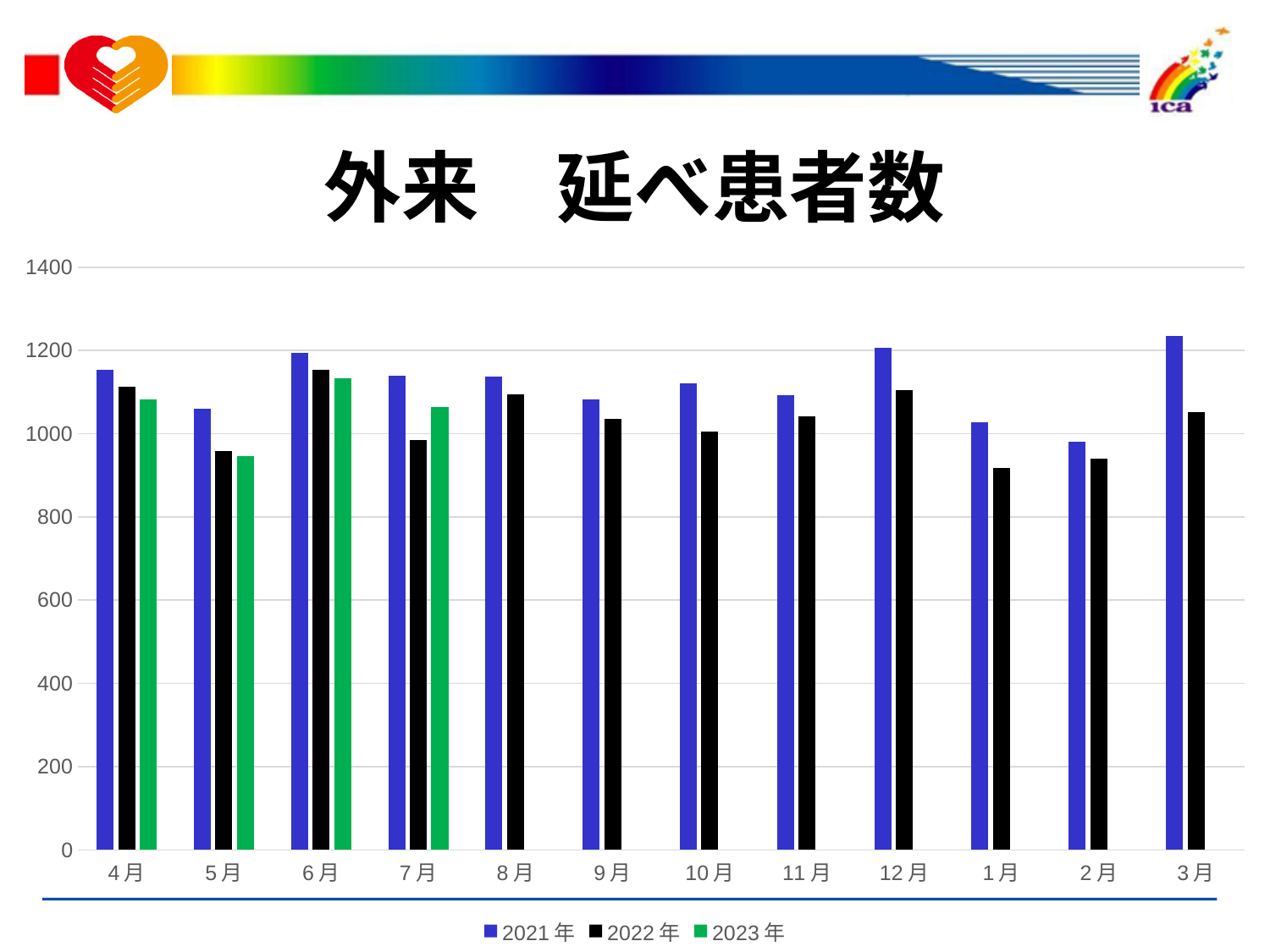
In which month is the 2021年 value highest? 3月 For 7月, which is larger, the 2022年 value or the 2023年 value? 2023年 Which colour represents the 2023年 series? green What kind of chart is shown on the slide? bar chart How many month categories are shown on the x axis? 12 Is the 2021年 value for 3月 greater or less than 1200? greater How many series does the legend list? 3 What is the title of the chart? 外来 延べ患者数 In which month is the 2021年 value lowest? 2月 For how many months does the 2023年 series have a bar? 4 Is the 2022年 value for 1月 greater or less than 1000? less In which month is the 2022年 value highest? 6月